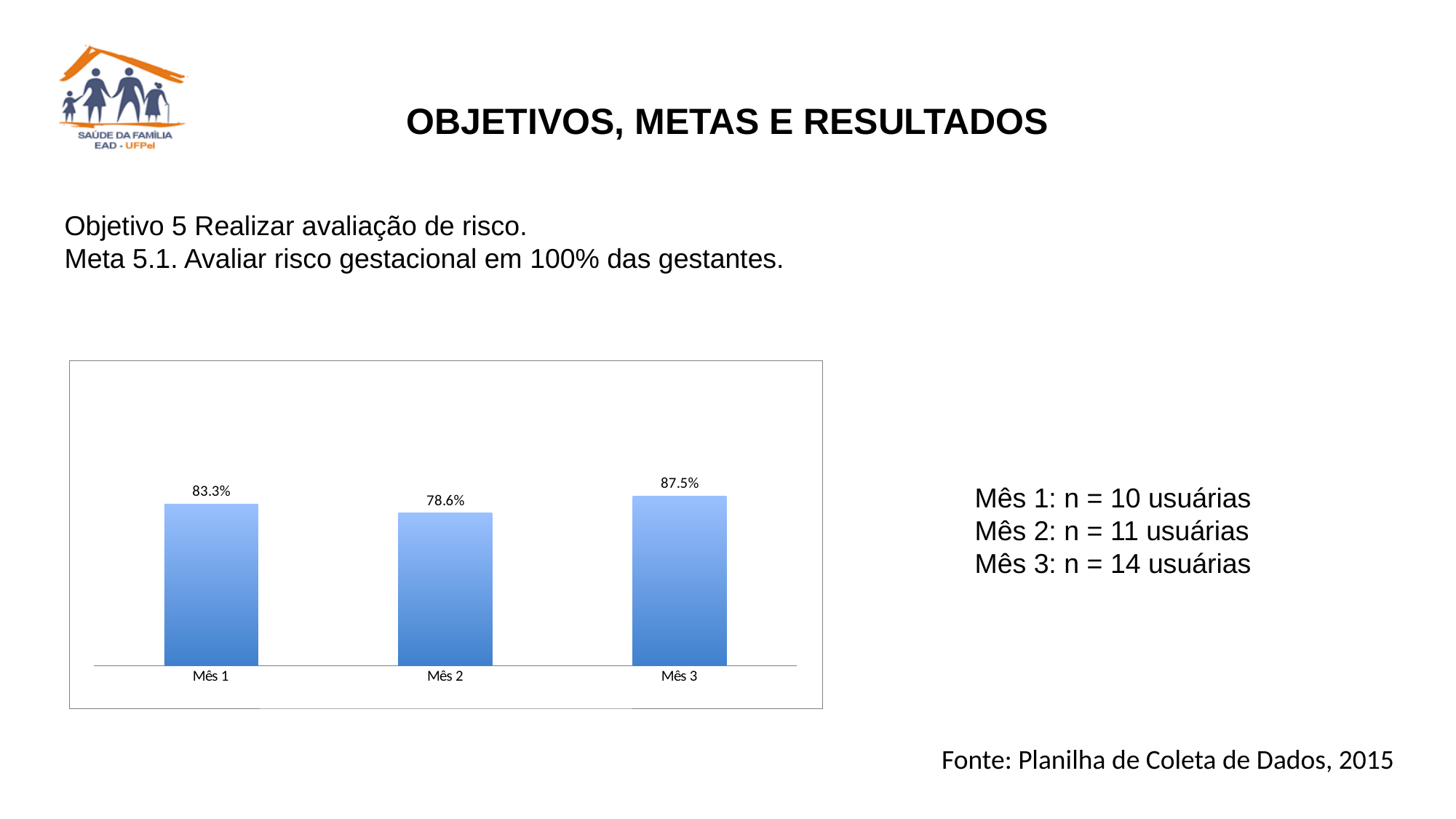
How many categories are shown in the chart? 3 What is the value for Mês 2? 78.6% Which month has the highest value? Mês 3 What is the value for Mês 3? 87.5% What is the difference between the values for Mês 1 and Mês 2? 4.7% What colour are the bars in the chart? Blue Does the value fall or rise from Mês 2 to Mês 3? Rise Which month has the lowest value? Mês 2 Which is larger, the value for Mês 1 or the value for Mês 3? Mês 3 What is the difference between the values for Mês 3 and Mês 2? 8.9% What kind of chart is shown on the slide? Bar chart What is the value for Mês 1? 83.3%